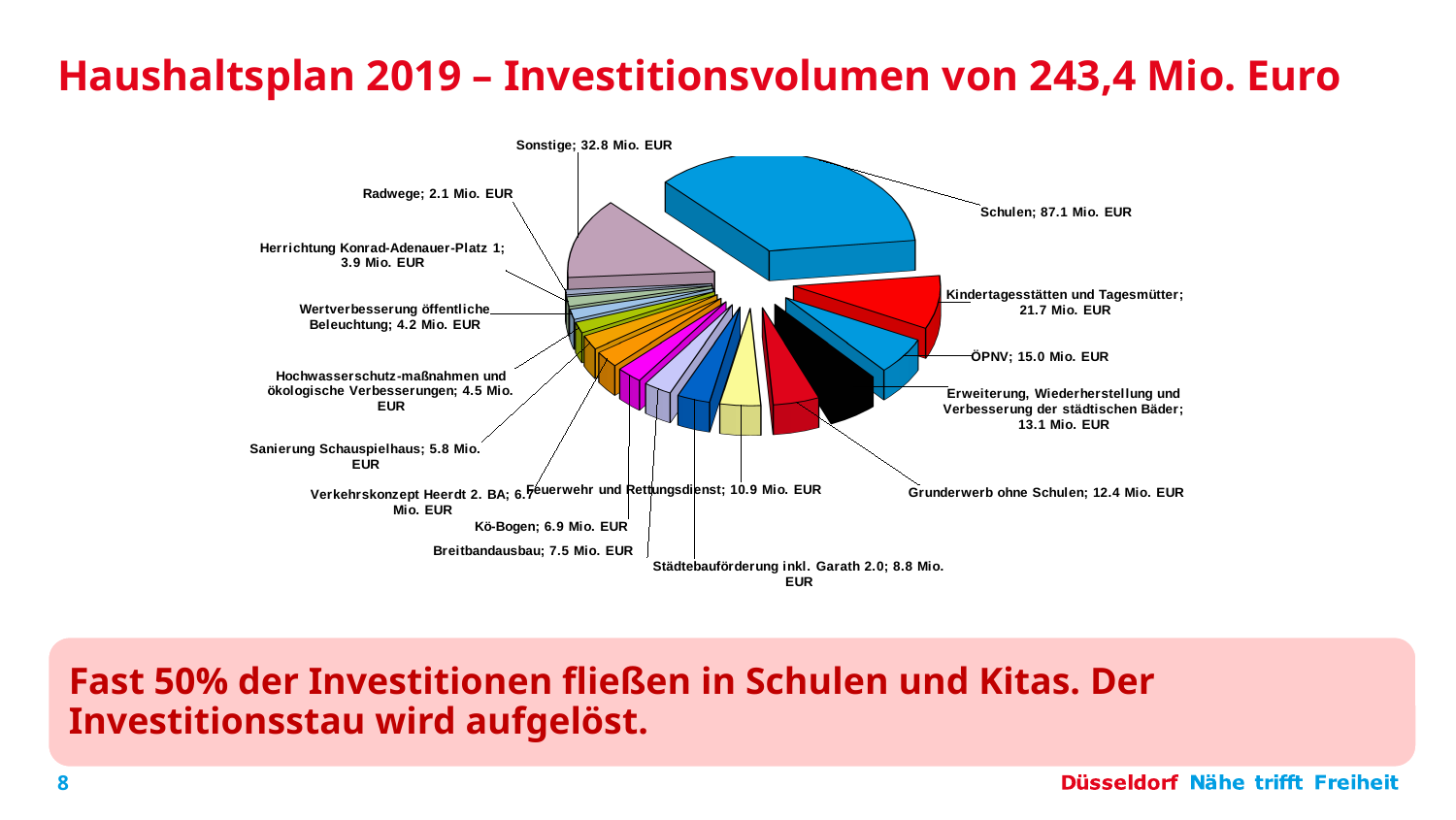
Which category has the smallest slice of the pie? Radwege Which category has the largest slice of the pie? Schulen What is the value for ÖPNV? 15.0 Mio. EUR What is the value for Feuerwehr und Rettungsdienst? 10.9 Mio. EUR What is the value for Kindertagesstätten und Tagesmütter? 21.7 Mio. EUR What is the difference between the values for Schulen and Kindertagesstätten und Tagesmütter? 65.4 Mio. EUR What is the total investment volume stated in the slide title? 243,4 Mio. Euro What is the value for Schulen? 87.1 Mio. EUR What is the value for Radwege? 2.1 Mio. EUR Which is larger, the value for Grunderwerb ohne Schulen or the value for Breitbandausbau? Grunderwerb ohne Schulen How many categories are shown in the pie chart? 16 What type of chart is shown on the slide? Pie chart